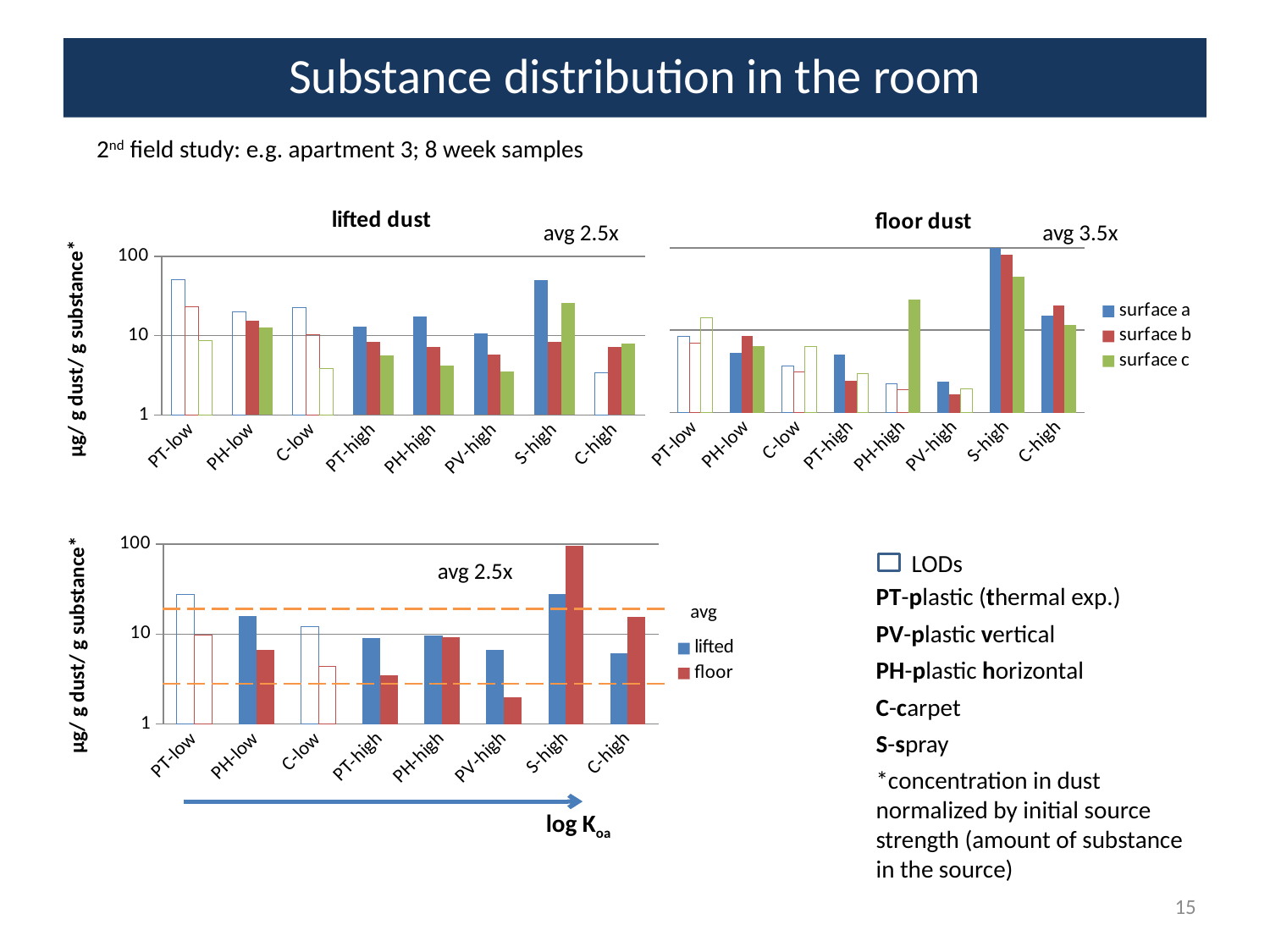
In the "floor dust" chart, which category has the highest bar? S-high How many categories are shown on the x axis of the "floor dust" chart? 8 How many series does the legend list for the "floor dust" chart? 3 In the "lifted dust" chart, is the value for PT-high surface a greater or less than 10? greater What average factor is annotated on the "floor dust" chart? avg 3.5x How many series does the legend list for the bottom chart (lifted vs floor)? 2 In the bottom chart (lifted vs floor), which is larger for C-high: lifted or floor? floor In the bottom chart (lifted vs floor), which is larger for PH-low: lifted or floor? lifted In the "floor dust" chart, is the value for PV-high surface b greater or less than 10? less In the "lifted dust" chart, is the value for PH-high surface c greater or less than 10? less What kind of chart is the "lifted dust" chart? bar chart